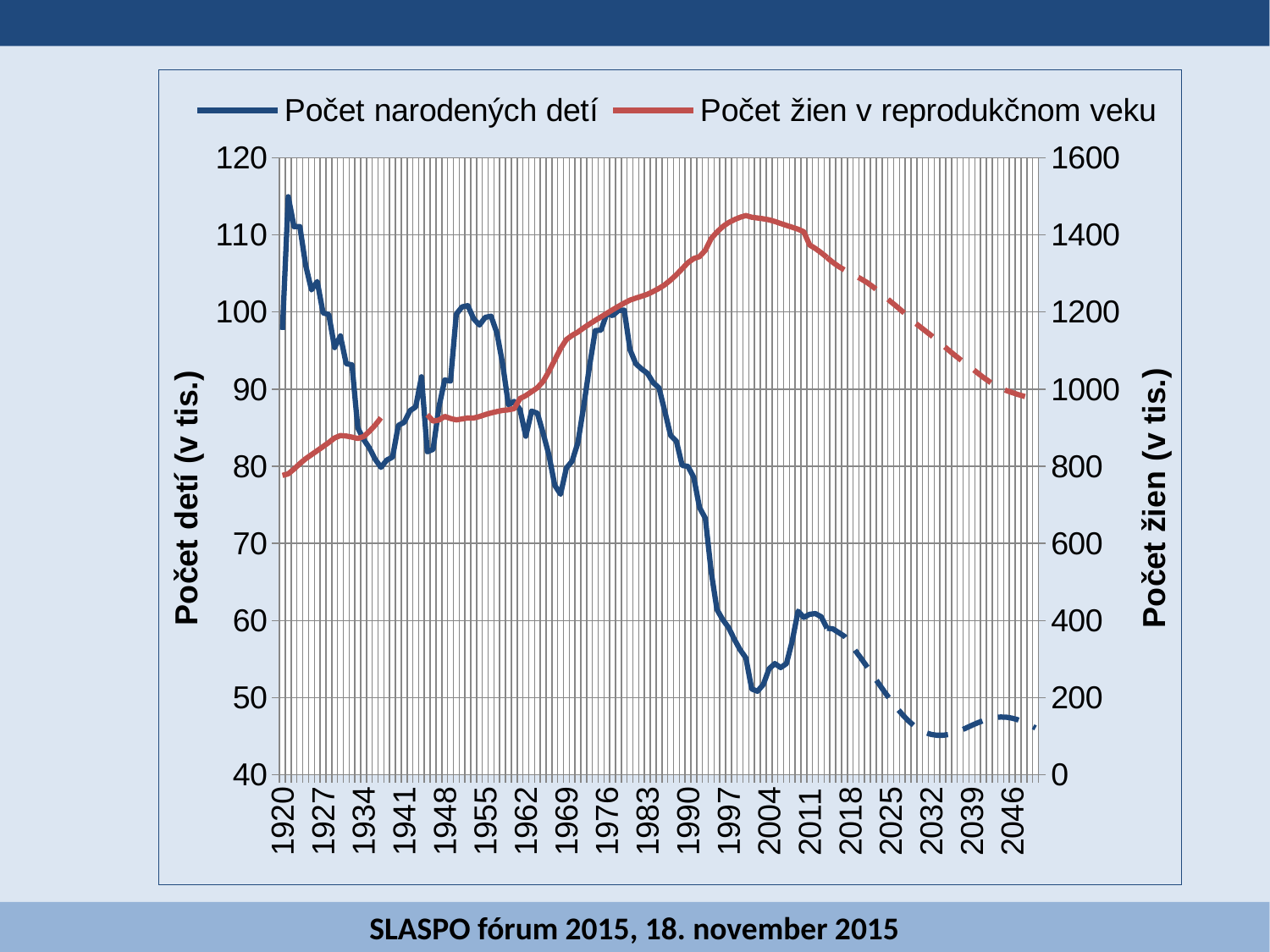
Does the 'Počet žien v reprodukčnom veku' line rise or fall between 1920 and 1997? rise Is the value of 'Počet žien v reprodukčnom veku' in 1976 greater or less than 1000? greater Is the value of 'Počet žien v reprodukčnom veku' around 2000 greater or less than 1400? greater What is the title of the left vertical axis? Počet detí (v tis.) Is the value of 'Počet narodených detí' in 2004 greater or less than 60? less What kind of chart is shown on the slide? line chart Does the 'Počet narodených detí' line rise or fall between 1976 and 2004? fall Which colour is used for the series 'Počet žien v reprodukčnom veku'? red Which series reaches its peak later along the x axis, 'Počet narodených detí' or 'Počet žien v reprodukčnom veku'? Počet žien v reprodukčnom veku How many series does the legend list? 2